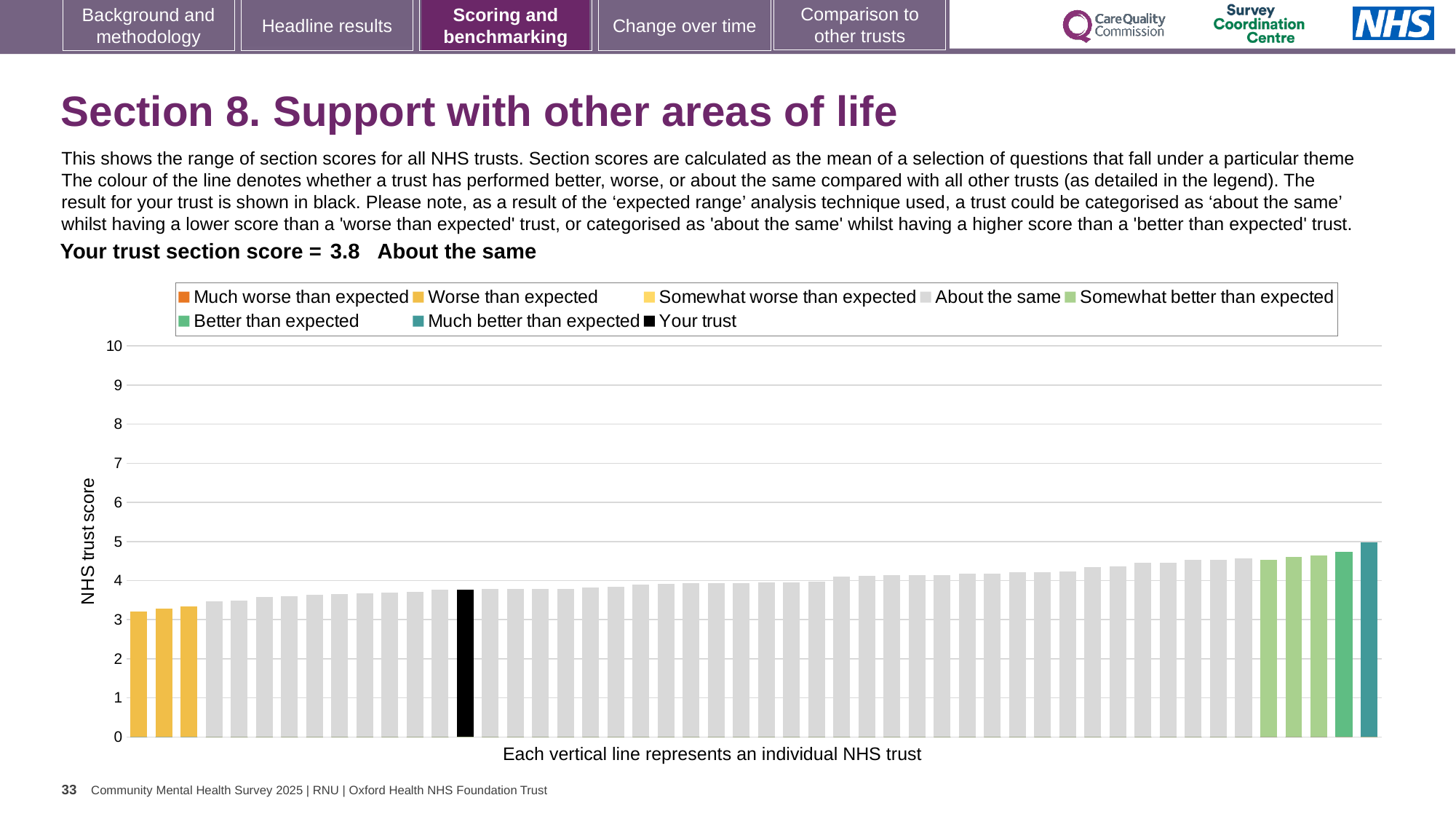
Do the bar values rise or fall from left to right along the x axis? rise Is the value for your trust greater or less than 4? less What is the section score for your trust? 3.8 How many bars are coloured as 'Worse than expected'? 3 Is the value of the tallest bar (the 'Much better than expected' trust) greater or less than 4? greater What is the label on the y axis of the chart? NHS trust score What kind of chart is shown on the slide? bar chart Which legend category does the tallest bar belong to? Much better than expected How many entries does the chart legend list? 8 Is the value of the shortest bar greater or less than 3? greater Which legend category do the shortest bars belong to? Worse than expected Is your trust's bar higher or lower than the 'Much better than expected' bar? lower